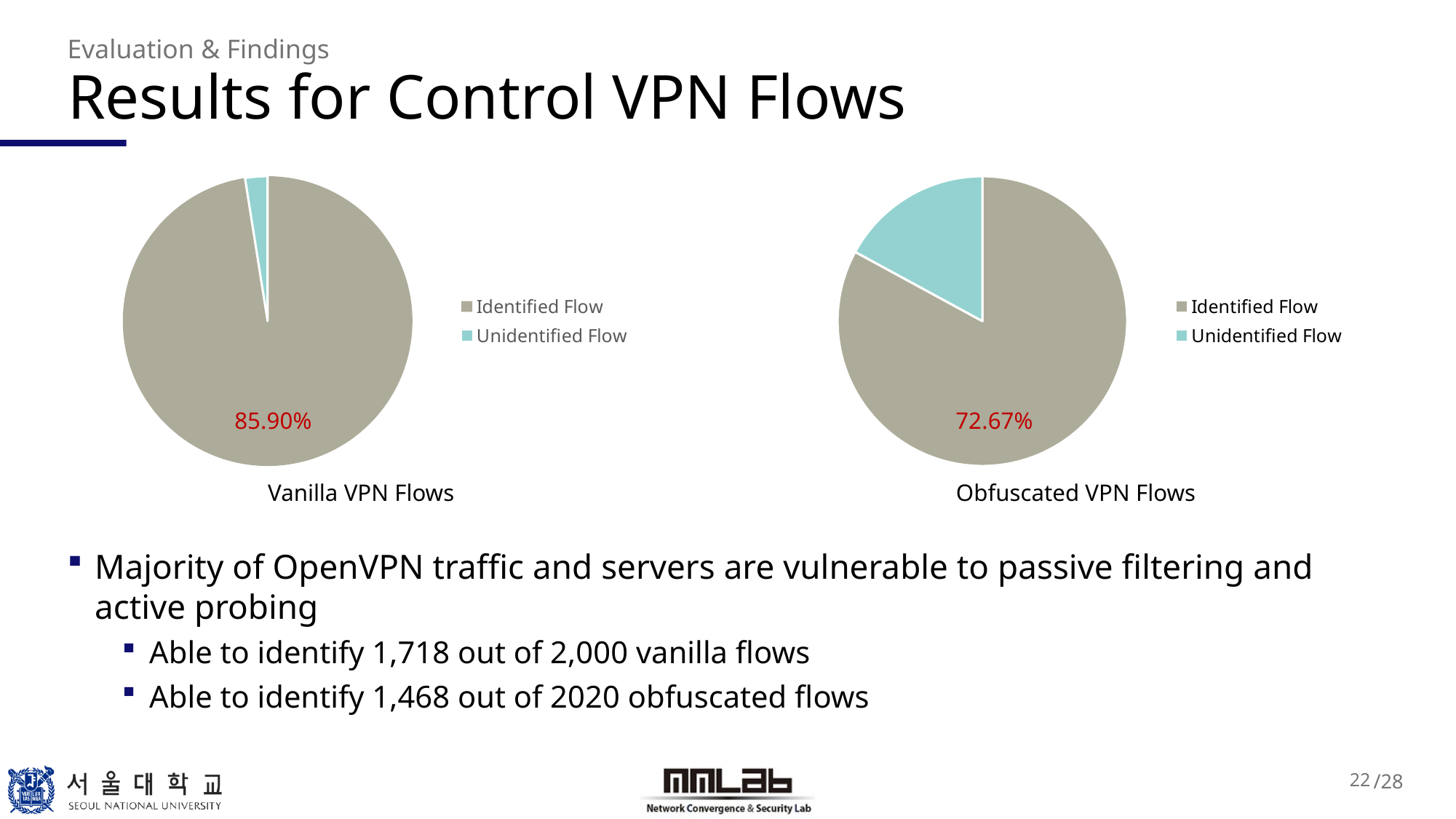
In the Vanilla VPN Flows pie chart, what share is labelled for Identified Flow? 85.90% What is the difference between the Identified Flow share in the Vanilla VPN Flows chart and in the Obfuscated VPN Flows chart? 13.23% In the Obfuscated VPN Flows pie chart, which slice is the smallest? Unidentified Flow Which chart shows a larger Identified Flow share, Vanilla VPN Flows or Obfuscated VPN Flows? Vanilla VPN Flows In the Vanilla VPN Flows pie chart, which slice is the largest? Identified Flow What kind of chart is the Vanilla VPN Flows chart? Pie chart In the Obfuscated VPN Flows pie chart, what share is labelled for Identified Flow? 72.67% In the Vanilla VPN Flows pie chart, what colour is the Unidentified Flow slice? Light blue What kind of chart is the Obfuscated VPN Flows chart? Pie chart How many entries does the legend of the Obfuscated VPN Flows pie chart list? 2 In the Obfuscated VPN Flows pie chart, is the Identified Flow share greater or less than 50%? greater How many slices does the Vanilla VPN Flows pie chart have? 2